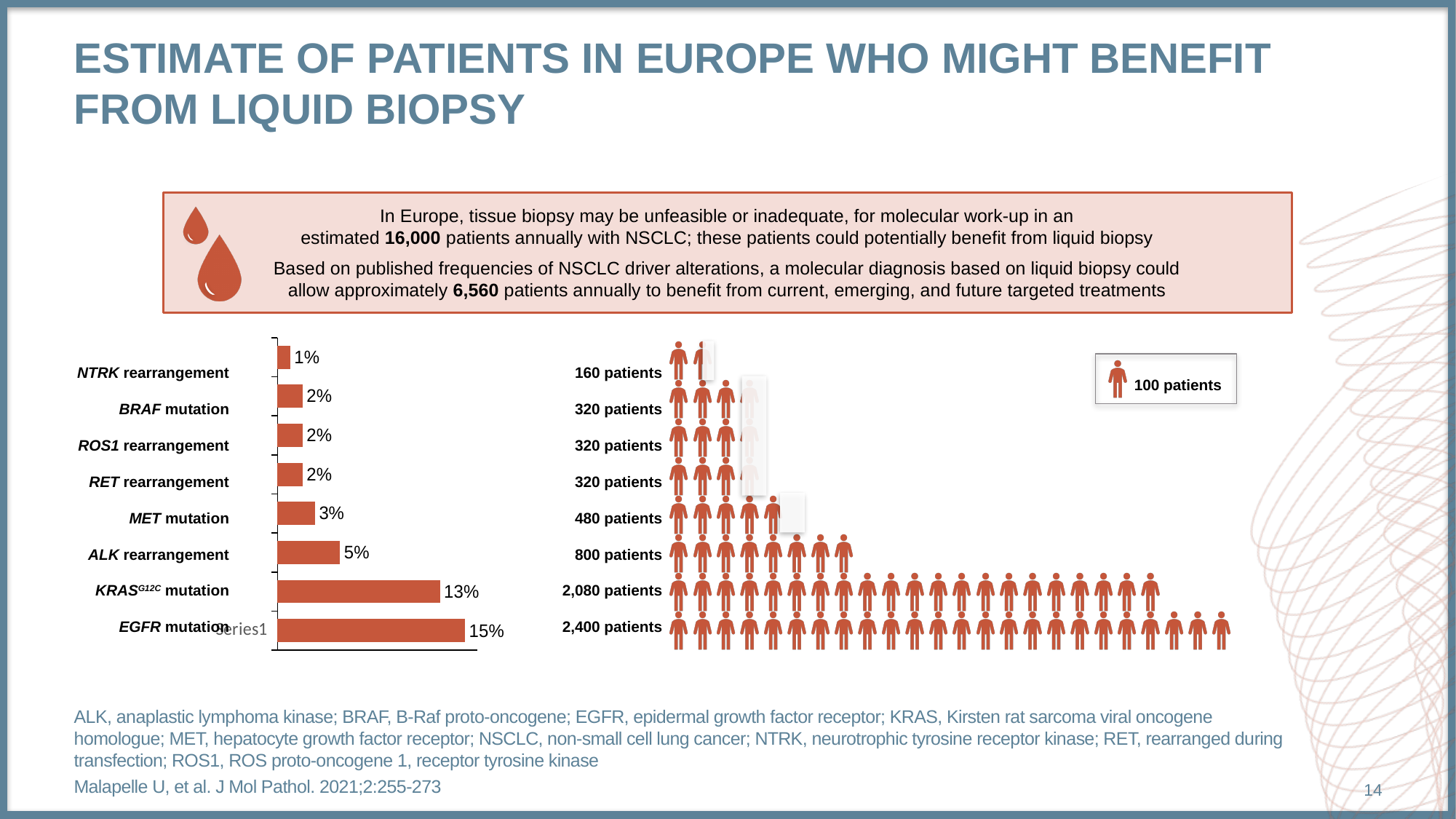
What percentage is shown for MET mutation in the bar chart? 3% How many alteration categories are shown in the bar chart? 8 Which alteration has the highest percentage in the bar chart? EGFR mutation What is the difference in percentage between EGFR mutation and KRAS G12C mutation? 2% How many patients are shown for KRAS G12C mutation in the pictogram? 2,080 patients According to the legend, how many patients does one person icon represent? 100 patients Which alteration has the lowest percentage in the bar chart? NTRK rearrangement What type of chart is used to show the alteration percentages? Bar chart What percentage is shown for ALK rearrangement in the bar chart? 5% What percentage is shown for EGFR mutation in the bar chart? 15% Which has a larger percentage, ALK rearrangement or MET mutation? ALK rearrangement How many patients are shown for NTRK rearrangement in the pictogram? 160 patients